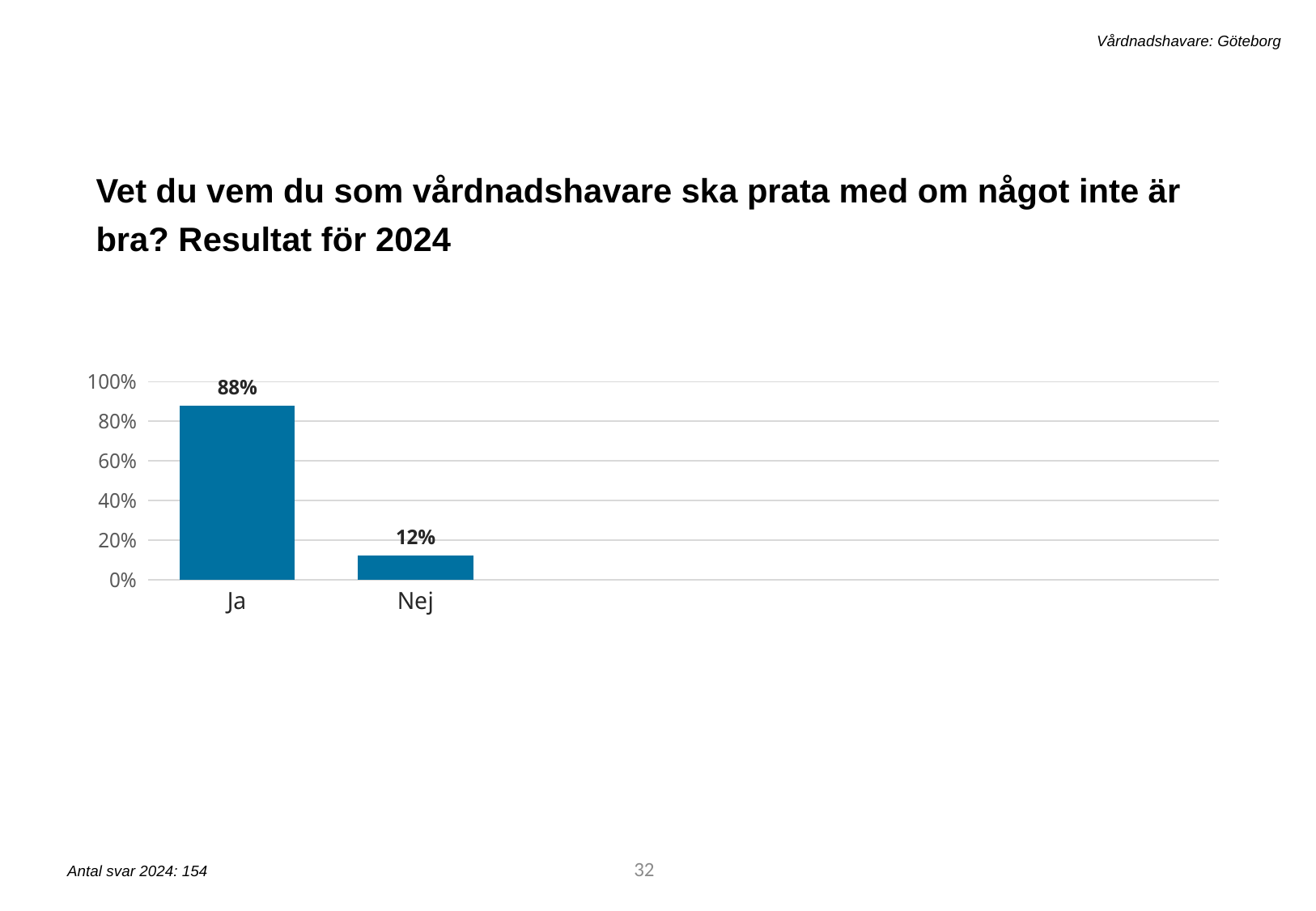
What kind of chart is shown on the slide? bar chart How many categories are shown on the x axis? 2 What is the value for Ja? 88% Which category has the lowest value? Nej What is the highest value shown on the y axis? 100% Which is larger, the value for Ja or the value for Nej? Ja What is the difference between the values for Ja and Nej? 76% What is the value for Nej? 12% What is the total of the values for Ja and Nej? 100% Is the value for Ja greater or less than 80%? greater Is the value for Nej greater or less than 20%? less Which category has the highest value? Ja